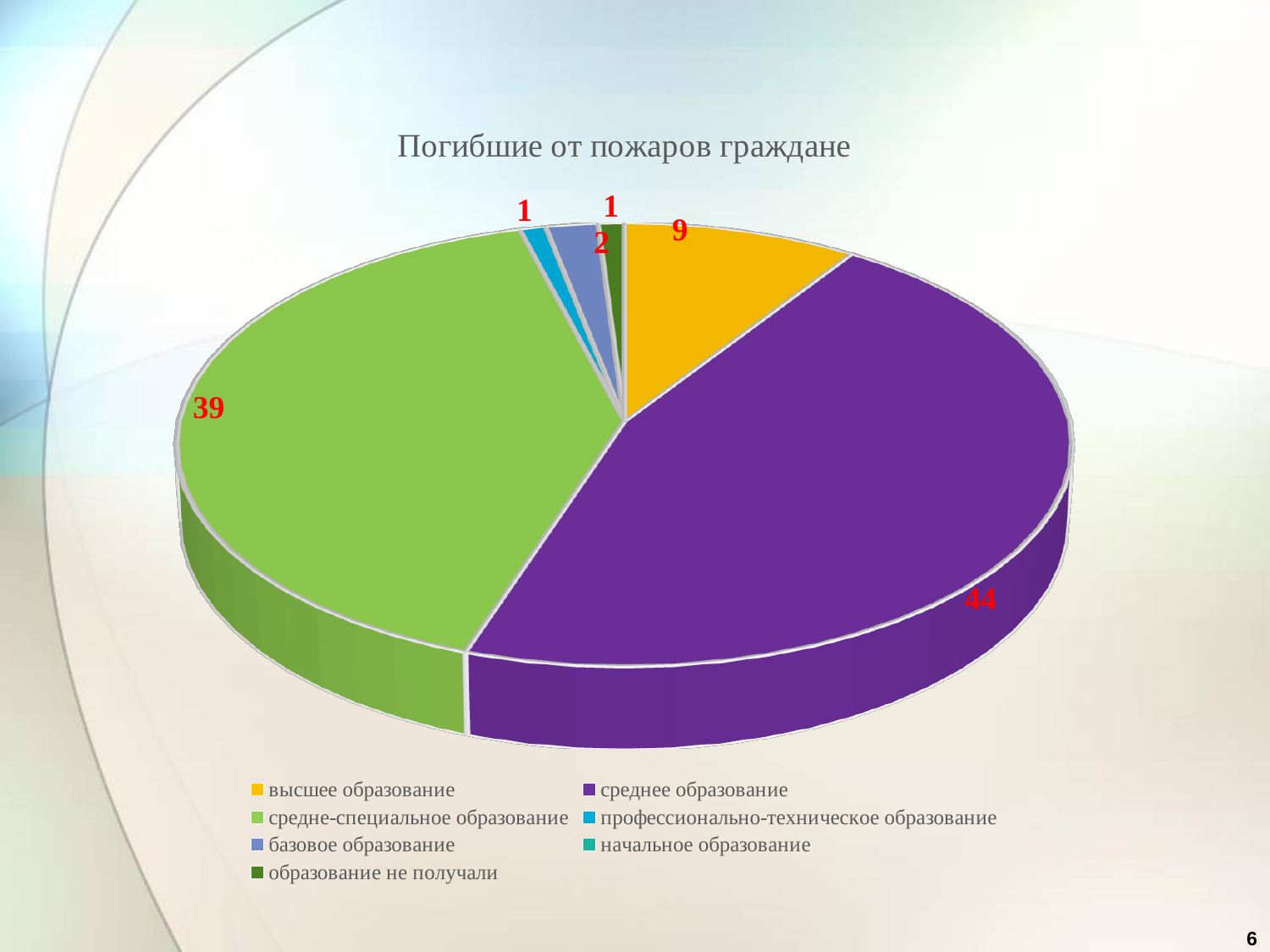
What is the value for средне-специальное образование? 39 What is the difference between the values for среднее образование and средне-специальное образование? 5 What is the difference between the values for средне-специальное образование and высшее образование? 30 Which is larger, the value for высшее образование or the value for базовое образование? высшее образование What is the title of the chart? Погибшие от пожаров граждане Which category has the largest slice? среднее образование What is the value for базовое образование? 2 What colour is the slice for среднее образование? purple How many categories does the legend list? 7 What is the value for высшее образование? 9 What is the value for среднее образование? 44 What kind of chart is shown on the slide? pie chart